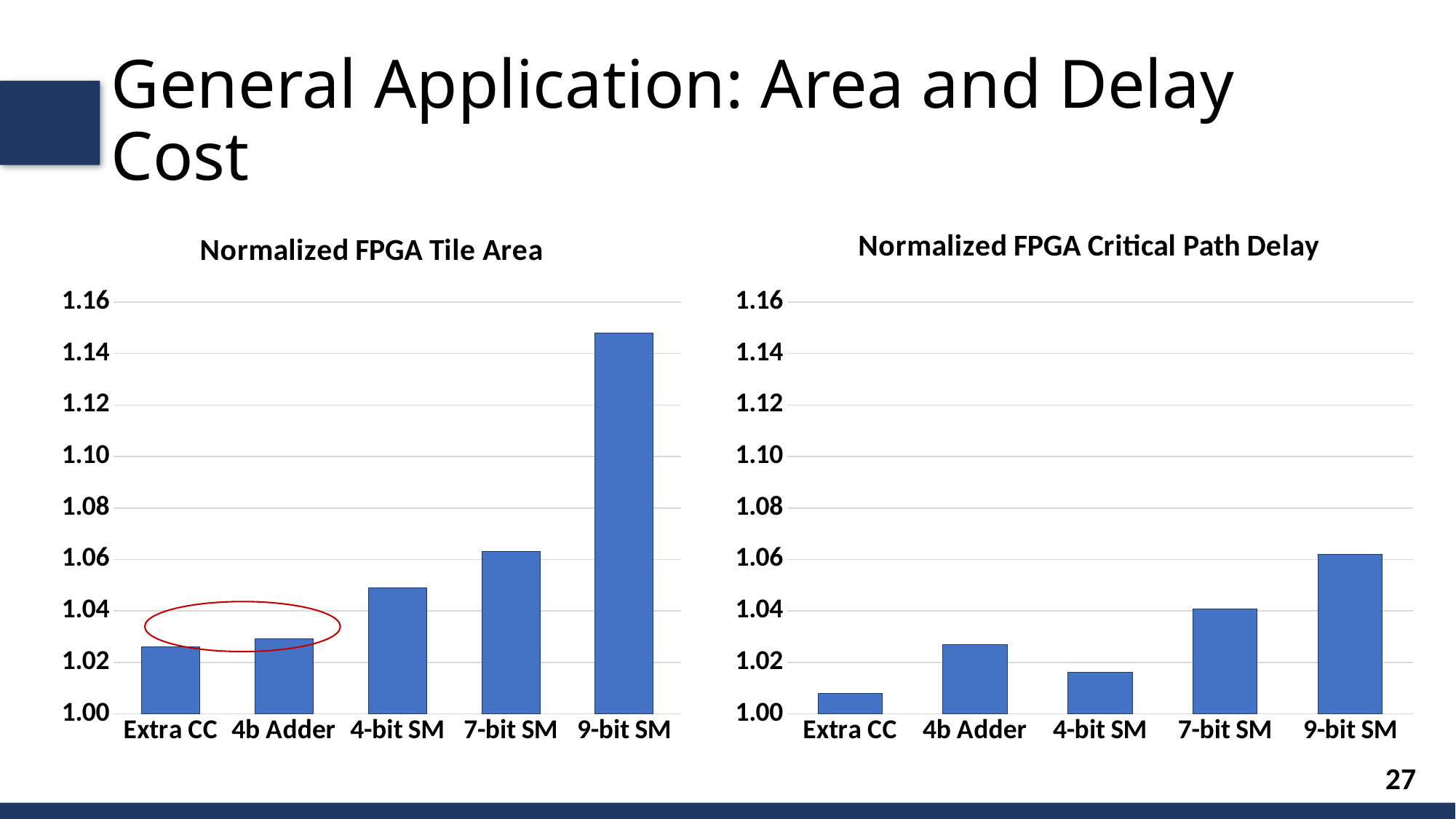
In the Normalized FPGA Critical Path Delay chart, is the value for 4-bit SM greater or less than 1.02? less In the Normalized FPGA Tile Area chart, do the values rise or fall from left to right along the x axis? rise In the Normalized FPGA Tile Area chart, which category has the lowest value? Extra CC How many categories are shown on the x axis of the Normalized FPGA Critical Path Delay chart? 5 In the Normalized FPGA Tile Area chart, is the value for 9-bit SM greater or less than 1.14? greater In the Normalized FPGA Tile Area chart, which is larger, the value for 7-bit SM or the value for 4-bit SM? 7-bit SM In the Normalized FPGA Critical Path Delay chart, which category has the highest value? 9-bit SM In the Normalized FPGA Critical Path Delay chart, which is larger, the value for 4b Adder or the value for 4-bit SM? 4b Adder What is the title of the chart on the right side of the slide? Normalized FPGA Critical Path Delay In the Normalized FPGA Critical Path Delay chart, which category has the lowest value? Extra CC In the Normalized FPGA Tile Area chart, which category has the highest value? 9-bit SM What kind of chart is the Normalized FPGA Tile Area chart? bar chart